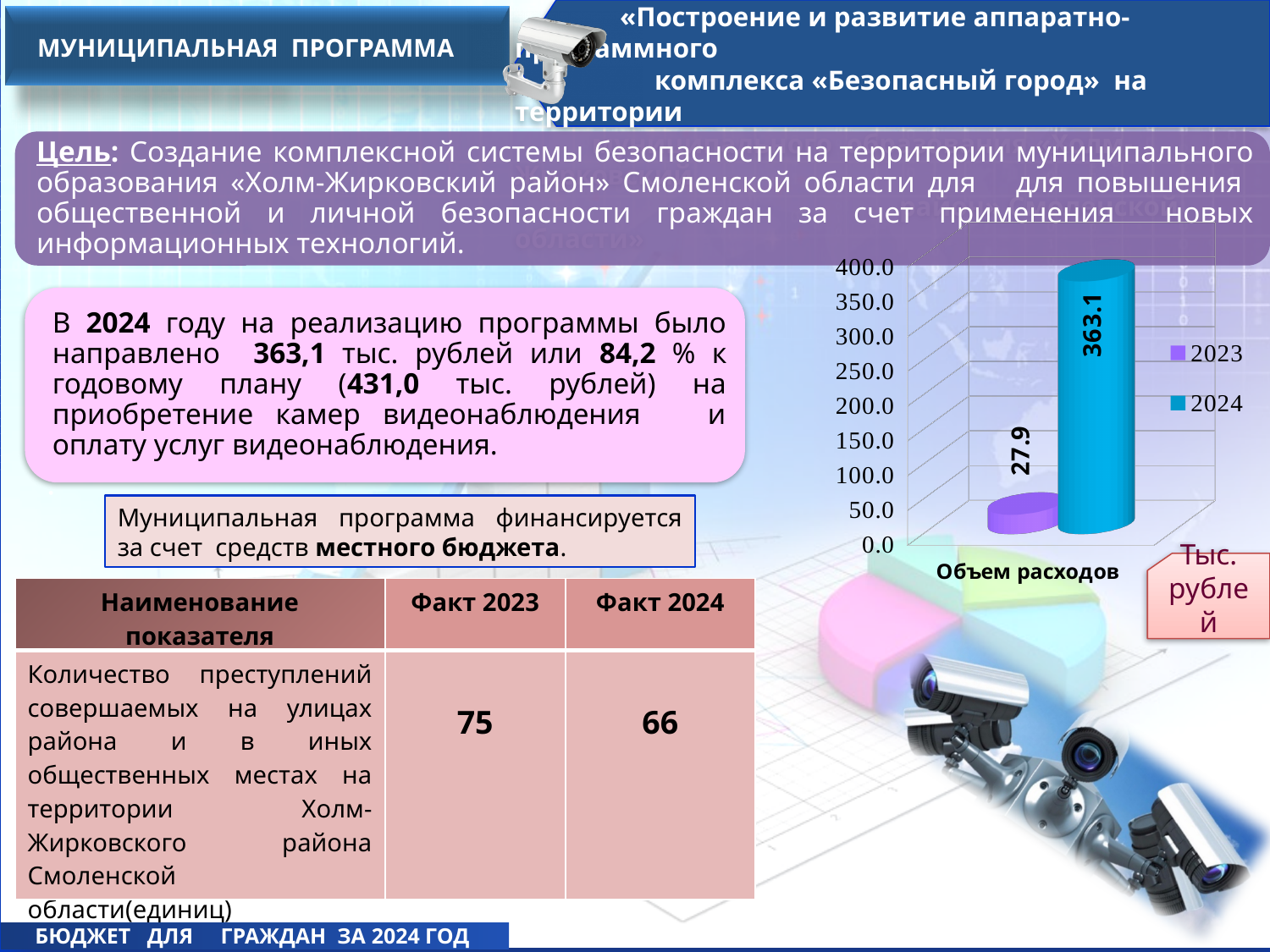
What is the value for 2024 in the chart? 363.1 What kind of chart is shown on the slide? bar chart What is the category label shown under the bars in the chart? Объем расходов What is the difference between the 2024 and 2023 values in the chart? 335.2 Which series has the higher value in the chart, 2023 or 2024? 2024 How many series does the chart legend list? 2 Which series has the lowest value in the chart? 2023 What is the value for 2023 in the chart? 27.9 What is the highest value shown on the chart's vertical axis? 400.0 Is the value for 2023 greater or less than 50.0? less How many categories are shown on the chart's x axis? 1 Is the value for 2024 greater or less than 350.0? greater